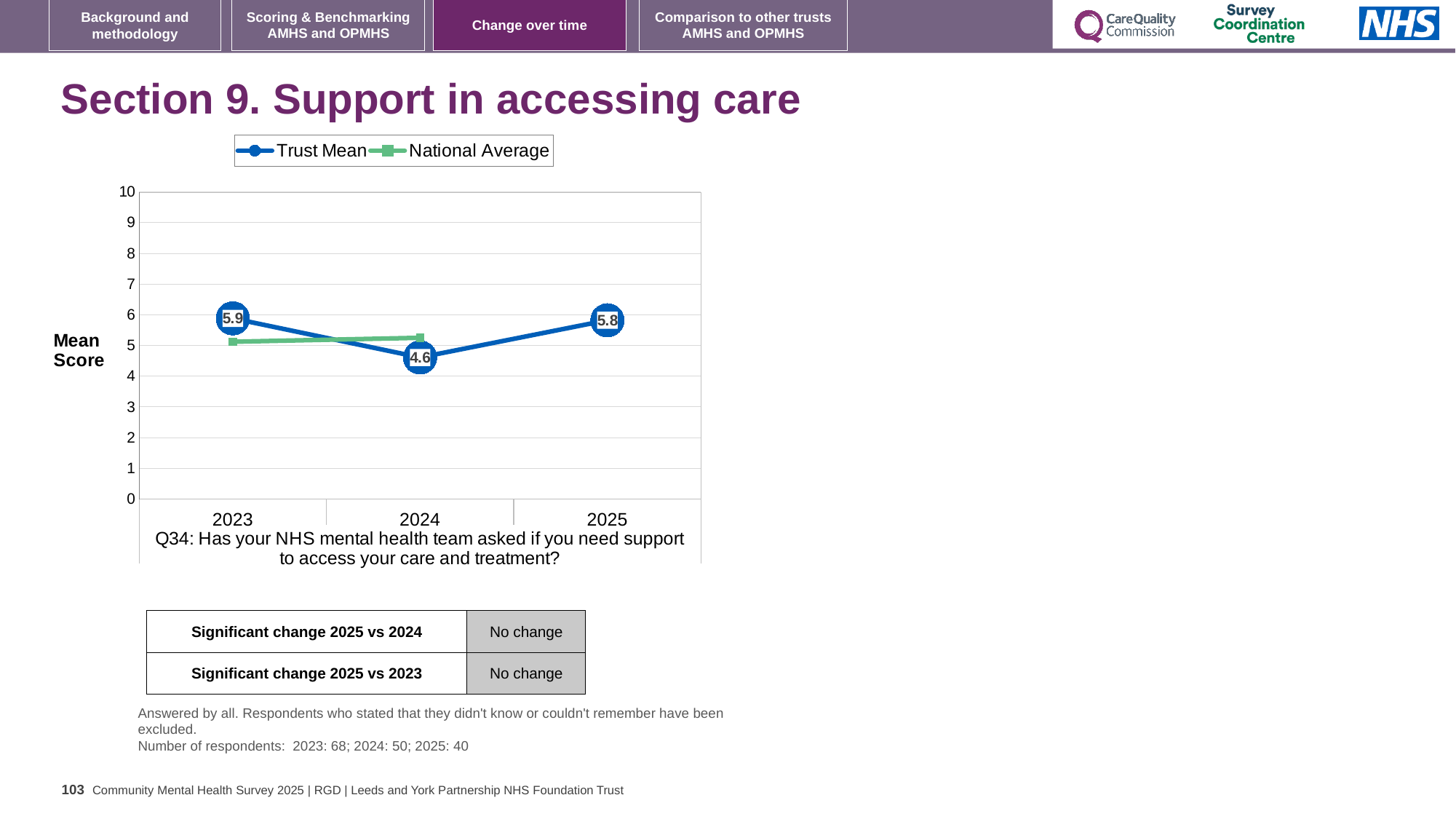
What kind of chart is shown on the slide? Line chart What is the Trust Mean score for 2025? 5.8 What is the Trust Mean score for 2024? 4.6 What is the Trust Mean score for 2023? 5.9 Is the National Average for 2023 greater or less than 6? less What is the difference between the Trust Mean in 2023 and 2024? 1.3 In which year is the Trust Mean highest? 2023 How many years are shown on the x axis? 3 Is the Trust Mean for 2025 larger than the Trust Mean for 2024? Yes Does the Trust Mean rise or fall from 2024 to 2025? Rise How many series does the legend list? 2 In which year is the Trust Mean lowest? 2024